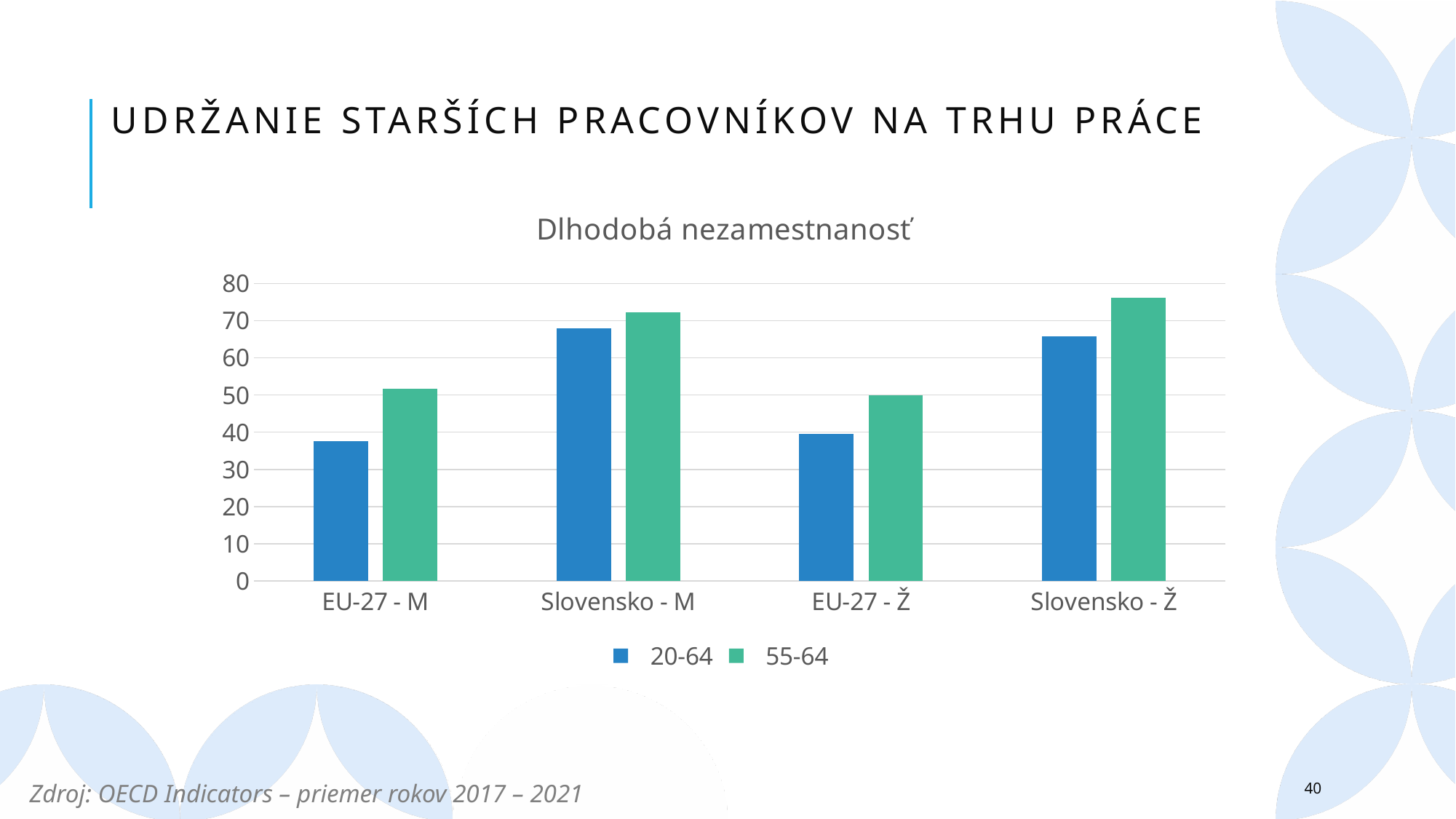
Is the 20-64 value for Slovensko - M greater or less than 60? greater What is the title of the chart? Dlhodobá nezamestnanosť How many series does the legend of the chart list? 2 Is the 20-64 value for EU-27 - M greater or less than 40? less Is the 55-64 value for EU-27 - M greater or less than 50? greater For EU-27 - Ž, which series has the larger value: 20-64 or 55-64? 55-64 What are the two series named in the legend? 20-64 and 55-64 How many categories are shown on the x axis of the chart? 4 What kind of chart is shown under the title "Dlhodobá nezamestnanosť"? bar chart For the 20-64 series, which is larger: the value for Slovensko - M or the value for EU-27 - M? Slovensko - M Which category has the highest value for the 55-64 series? Slovensko - Ž